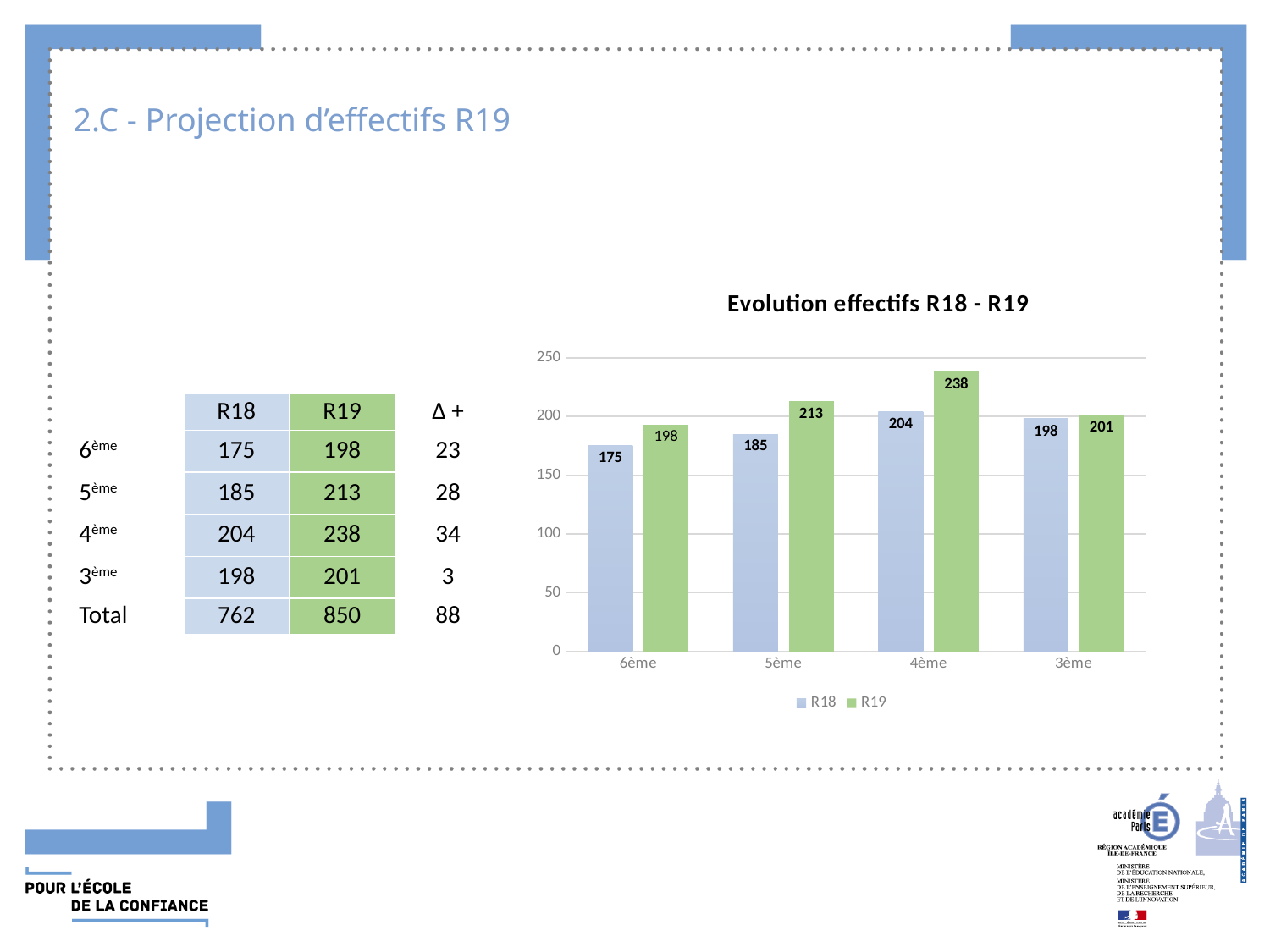
How many categories are shown on the x axis of the chart? 4 Which colour represents the R19 series in the chart? green What is the title of the chart? Evolution effectifs R18 - R19 Is the R19 value for 4ème greater or less than 200? greater Which category has the lowest R18 value in the chart? 6ème Which is larger for 3ème: the R18 value or the R19 value? R19 What is the difference between the R19 and R18 values for 5ème? 28 What type of chart is shown on the slide? bar chart How many series does the chart legend list? 2 What is the R18 value for 6ème in the chart? 175 Which category has the highest R19 value in the chart? 4ème What is the R19 value for 4ème in the chart? 238